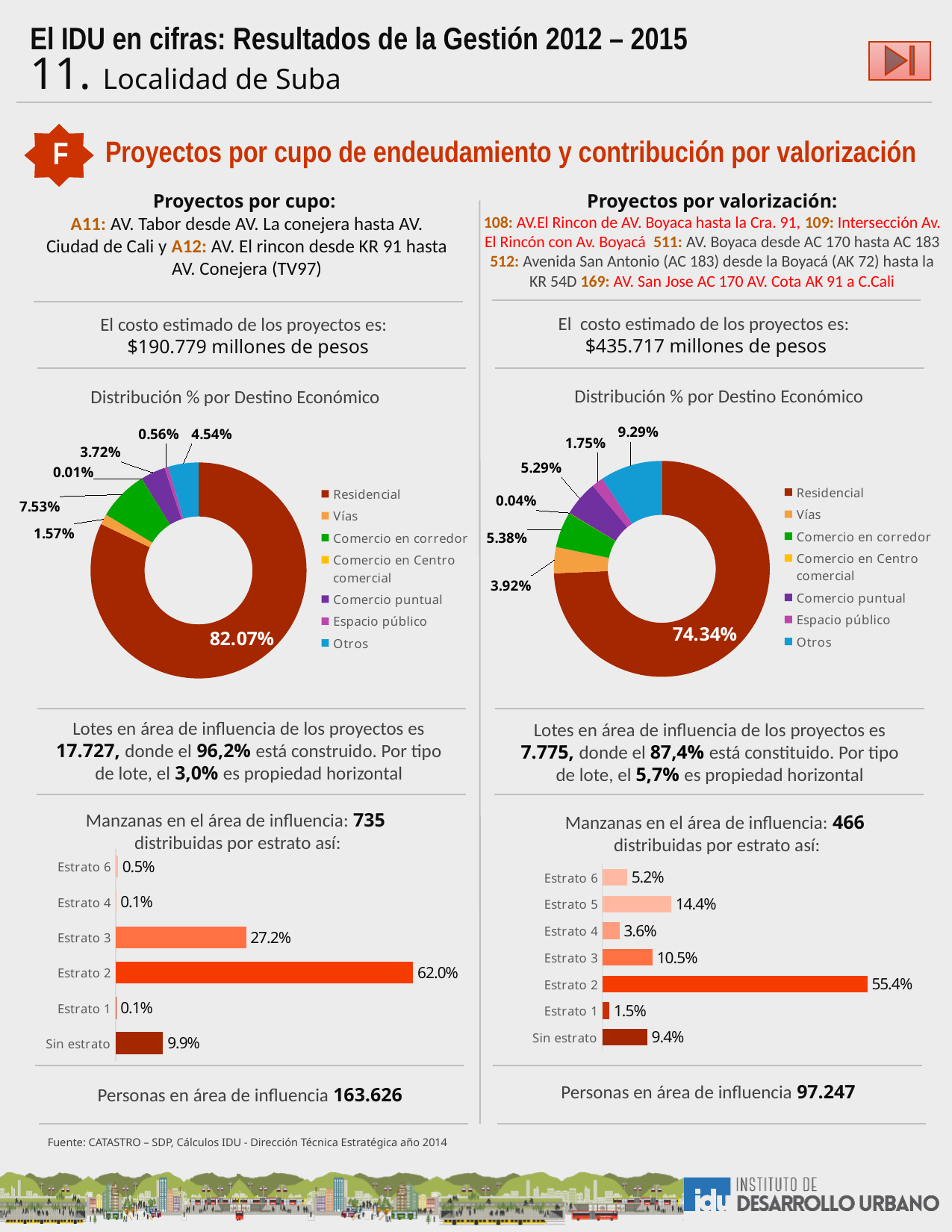
In the right donut chart (Proyectos por valorización), what share is Otros? 9.29% In the right bar chart (Manzanas en el área de influencia, Proyectos por valorización), which estrato has the highest value? Estrato 2 What type of chart is used for the Manzanas en el área de influencia distribution on the left side of the slide? Bar chart In the right bar chart (Manzanas en el área de influencia, Proyectos por valorización), what is the value for Estrato 5? 14.4% In the left bar chart (Manzanas en el área de influencia, Proyectos por cupo), what is the value for Estrato 2? 62.0% In the right donut chart (Proyectos por valorización, Distribución % por Destino Económico), what share is Residencial? 74.34% In the left donut chart (Proyectos por cupo), which category has the smallest share? Comercio en Centro comercial In the left bar chart (Manzanas en el área de influencia, Proyectos por cupo), what is the difference between Estrato 2 and Estrato 3? 34.8% In the right bar chart (Manzanas en el área de influencia, Proyectos por valorización), which is larger: Estrato 3 or Sin estrato? Estrato 3 How many entries does the legend of the left donut chart (Proyectos por cupo) list? 7 How many categories are shown in the right bar chart (Manzanas en el área de influencia, Proyectos por valorización)? 7 In the left donut chart (Proyectos por cupo, Distribución % por Destino Económico), what share is Residencial? 82.07%